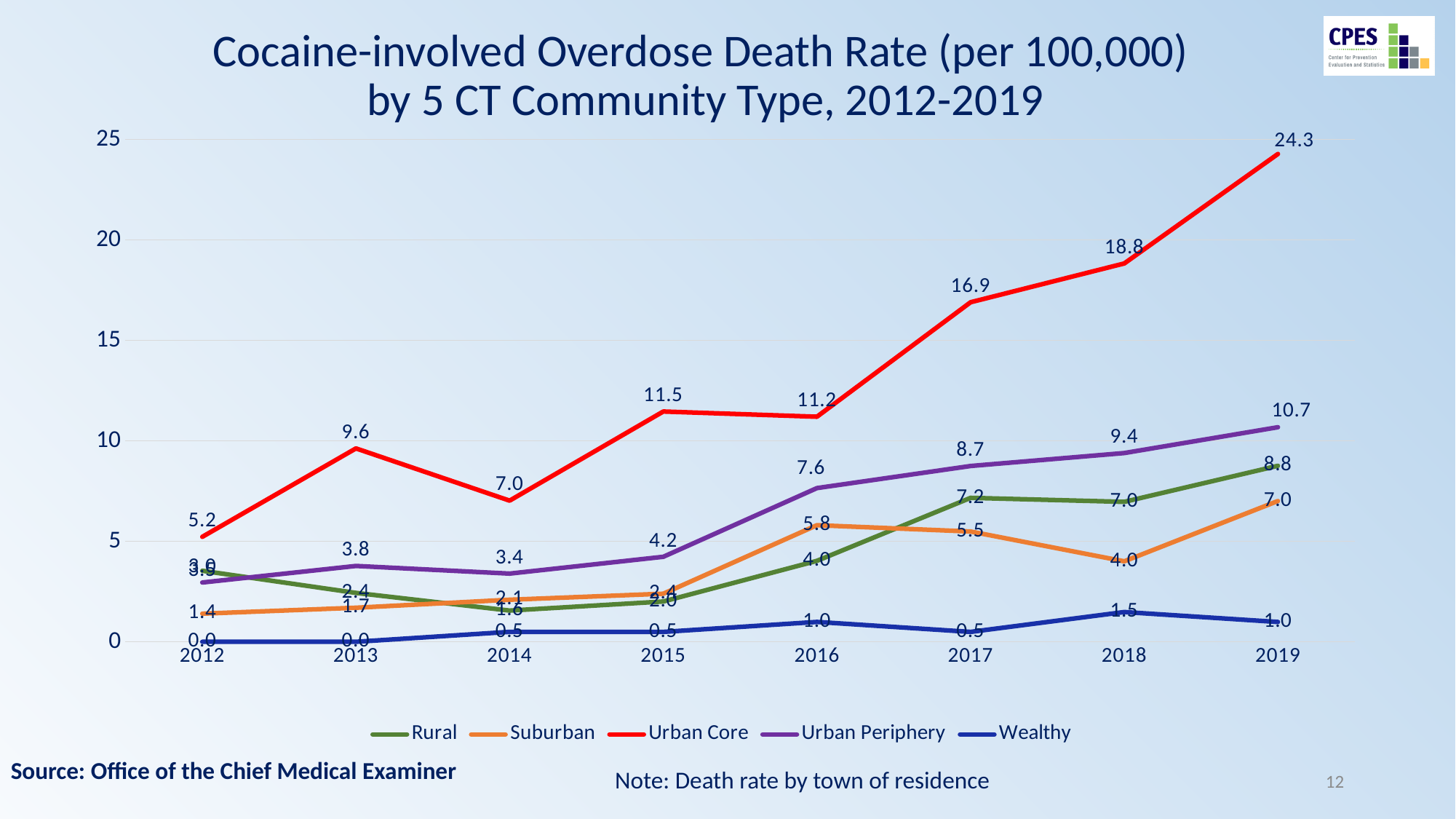
What is the Wealthy value in 2018? 1.5 In 2017, which is higher: Rural or Suburban? Rural In which year is the Urban Core rate lowest? 2012 In which year is the Urban Core rate highest? 2019 What is the Urban Core cocaine-involved overdose death rate in 2019? 24.3 How many years are shown on the x axis? 8 What is the Suburban value in 2016? 5.8 Is the Urban Core value for 2017 greater or less than 15? greater What kind of chart is shown on the slide? Line chart How many community types does the legend list? 5 What is the Urban Periphery value in 2018? 9.4 How much did the Urban Core rate increase from 2018 to 2019? 5.5